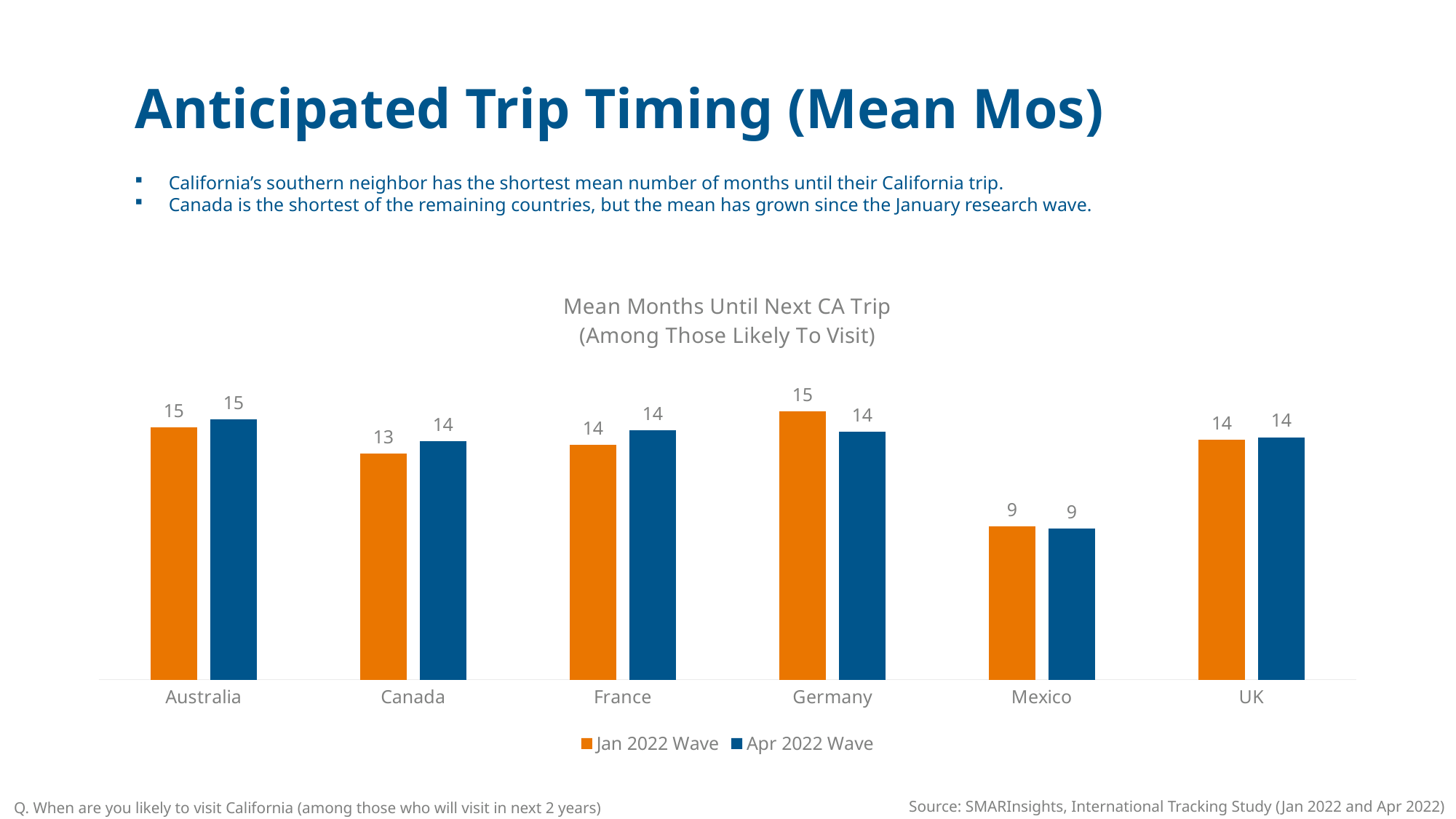
How many series does the legend list? 2 Which is larger for Germany: the Jan 2022 Wave value or the Apr 2022 Wave value? Jan 2022 Wave What is the Jan 2022 Wave value for Canada? 13 What is the title of the chart? Mean Months Until Next CA Trip (Among Those Likely To Visit) Which is larger: the Jan 2022 Wave value for Australia or the Jan 2022 Wave value for Mexico? Australia What is the Jan 2022 Wave value for Mexico? 9 How many countries are shown on the x axis? 6 What kind of chart is shown on the slide? Bar chart What is the Apr 2022 Wave value for Germany? 14 What is the difference between the Jan 2022 Wave and Apr 2022 Wave values for Canada? 1 Which country has the lowest Apr 2022 Wave value? Mexico Which country has the highest Apr 2022 Wave value? Australia